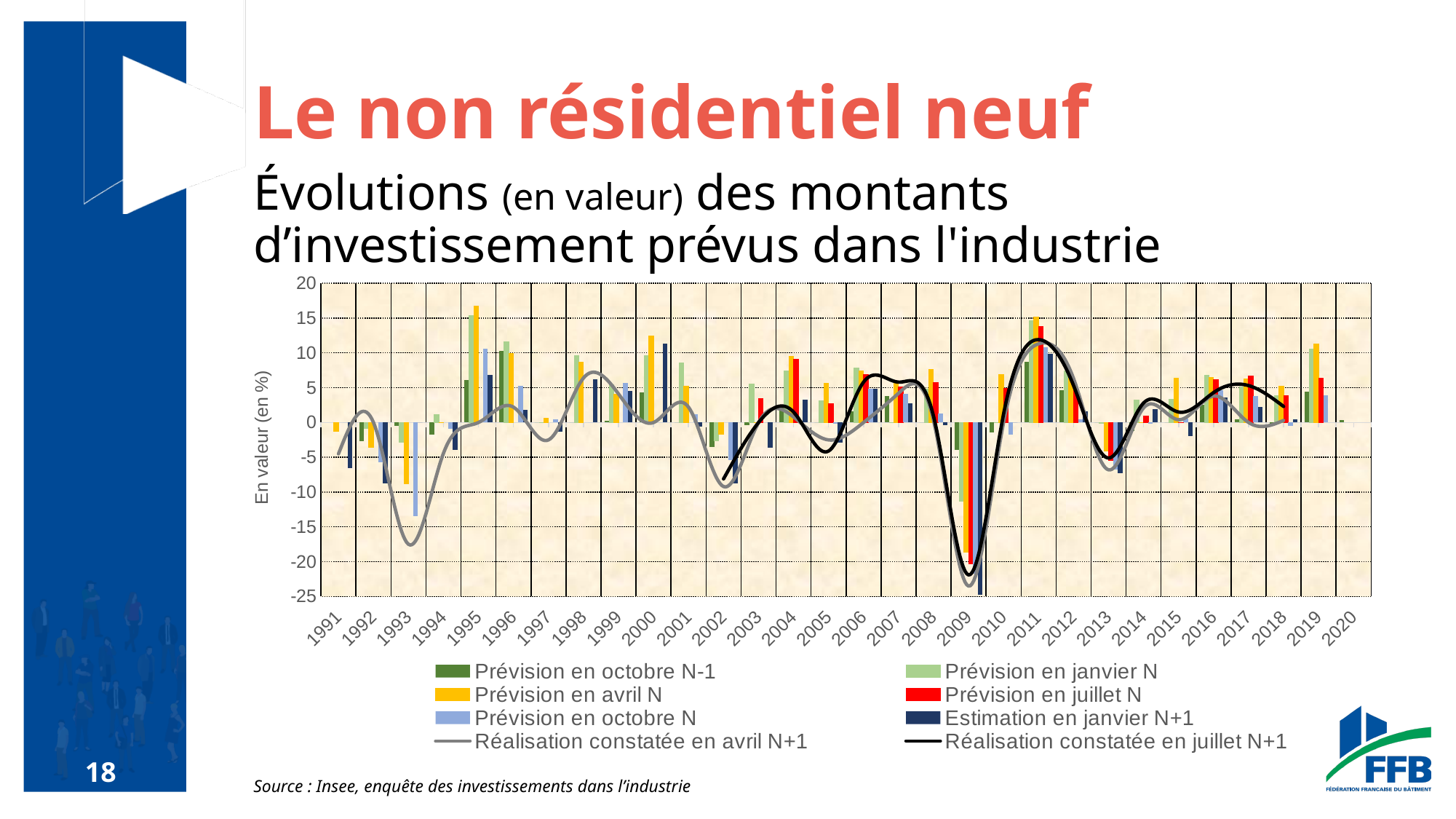
What kind of chart is shown on the slide? A combined bar and line chart How many series does the legend list? 8 Is the value of Prévision en avril N for 1995 greater or less than 15? greater In which year does the Réalisation constatée en avril N+1 line reach its lowest point? 2009 Is the value of Prévision en octobre N for 1993 greater or less than -10? less Is the value of Prévision en juillet N for 2011 greater or less than 10? greater Does the Réalisation constatée en juillet N+1 line rise or fall between 2011 and 2013? fall Which series is drawn as a black line? Réalisation constatée en juillet N+1 What is the label of the vertical axis? En valeur (en %) How many years are shown along the x axis? 30 Does the Réalisation constatée en avril N+1 line rise or fall between 2009 and 2011? rise